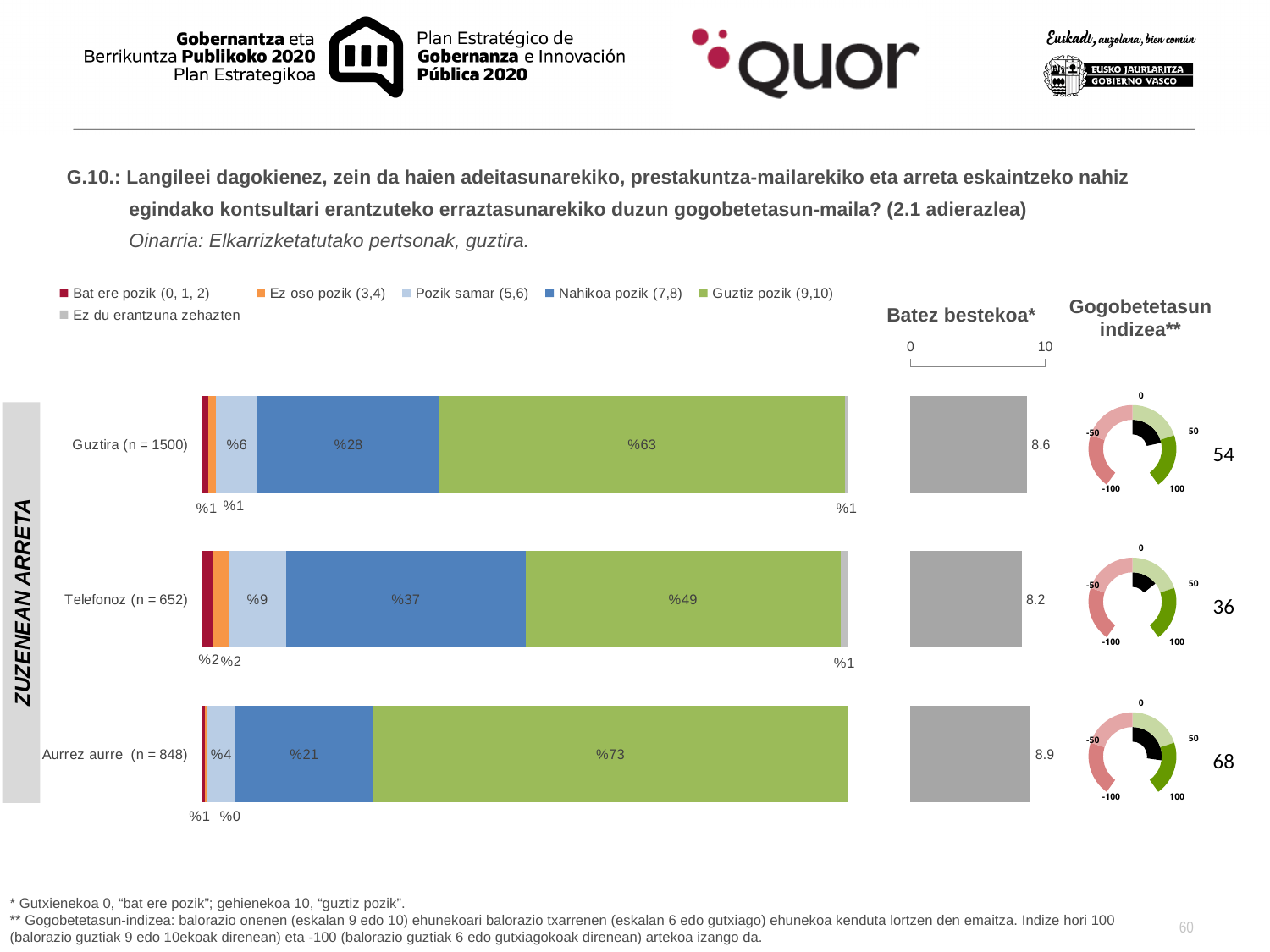
How many series does the legend of the stacked bar chart list? 6 In the stacked bar chart, what is the difference between the 'Guztiz pozik (9,10)' values for Aurrez aurre (n = 848) and Telefonoz (n = 652)? 24 percentage points In the 'Batez bestekoa*' chart, which category has the highest value? Aurrez aurre (n = 848) In the 'Gogobetetasun indizea**' gauges, what is the value for Guztira (n = 1500)? 54 In the stacked bar chart, which category has the lowest 'Guztiz pozik (9,10)' value? Telefonoz (n = 652) In the 'Batez bestekoa*' chart, what is the value for Telefonoz (n = 652)? 8.2 In the stacked bar chart, what is the value of 'Guztiz pozik (9,10)' for Aurrez aurre (n = 848)? %73 In the stacked bar chart, what is the value of 'Pozik samar (5,6)' for Guztira (n = 1500)? %6 How many categories are shown in the stacked bar chart? 3 In the stacked bar chart, which category has the highest 'Guztiz pozik (9,10)' value? Aurrez aurre (n = 848) In the stacked bar chart, is the 'Nahikoa pozik (7,8)' value larger for Guztira (n = 1500) or for Telefonoz (n = 652)? Telefonoz (n = 652) In the stacked bar chart, what is the value of 'Nahikoa pozik (7,8)' for Telefonoz (n = 652)? %37